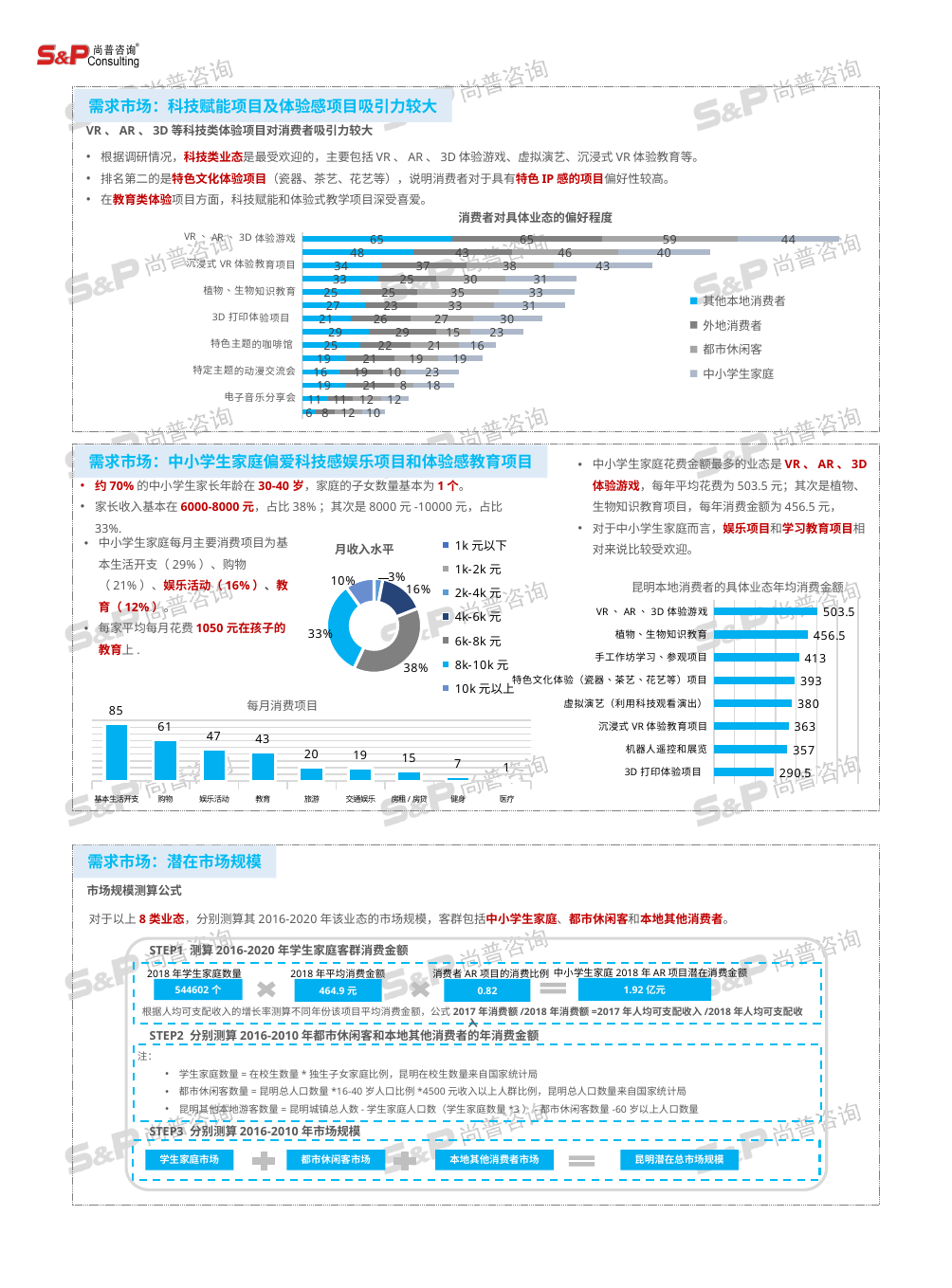
In the chart titled 每月消费项目, how many categories are shown? 9 In the chart titled 昆明本地消费者的具体业态年均消费金额, what is the difference between the values for VR、AR、3D 体验游戏 and 3D 打印体验项目? 213 In the chart titled 每月消费项目, what is the difference between the values for 购物 and 教育? 18 In the chart titled 每月消费项目, what is the value for 基本生活开支? 85 In the chart titled 昆明本地消费者的具体业态年均消费金额, which is larger: 手工作坊学习、参观项目 or 机器人遥控和展览? 手工作坊学习、参观项目 In the chart titled 昆明本地消费者的具体业态年均消费金额, what is the value for 虚拟演艺（利用科技观看演出）? 380 In the chart titled 消费者对具体业态的偏好程度, how many series does the legend list? 4 In the chart titled 昆明本地消费者的具体业态年均消费金额, which category has the highest value? VR、AR、3D 体验游戏 In the chart titled 每月消费项目, do the values rise or fall from left to right? fall What kind of chart is the chart titled 月收入水平? doughnut chart In the chart titled 每月消费项目, which category has the lowest value? 医疗 In the chart titled 月收入水平, how many entries does the legend list? 7